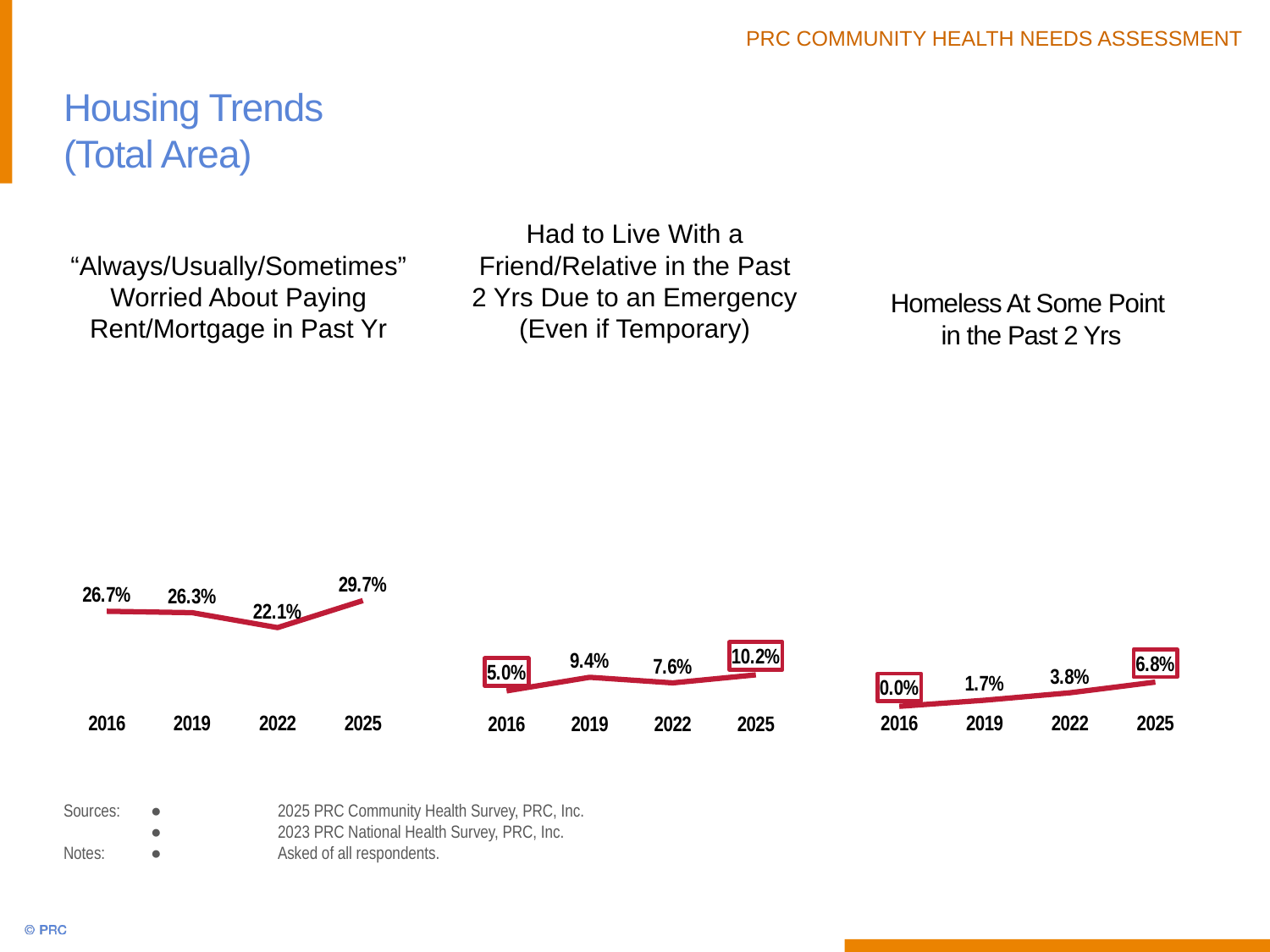
In the "Homeless At Some Point in the Past 2 Yrs" chart, do the values rise or fall from 2016 to 2025? rise In the "Worried About Paying Rent/Mortgage in Past Yr" chart, which year has the lowest value? 2022 In the "Homeless At Some Point in the Past 2 Yrs" chart, what is the value for 2016? 0.0% In the "Worried About Paying Rent/Mortgage in Past Yr" chart, what is the value for 2025? 29.7% In the "Worried About Paying Rent/Mortgage in Past Yr" chart, what is the difference between the 2025 and 2022 values? 7.6 percentage points In the "Had to Live With a Friend/Relative in the Past 2 Yrs Due to an Emergency" chart, what is the value for 2019? 9.4% How many charts are shown on the slide? 3 In the "Had to Live With a Friend/Relative in the Past 2 Yrs Due to an Emergency" chart, is the value for 2019 or 2022 larger? 2019 In the "Homeless At Some Point in the Past 2 Yrs" chart, what is the difference between the 2025 and 2022 values? 3.0 percentage points In the "Had to Live With a Friend/Relative in the Past 2 Yrs Due to an Emergency" chart, which year has the highest value? 2025 What kind of chart is the "Worried About Paying Rent/Mortgage in Past Yr" chart? line chart How many years are plotted in the "Homeless At Some Point in the Past 2 Yrs" chart? 4